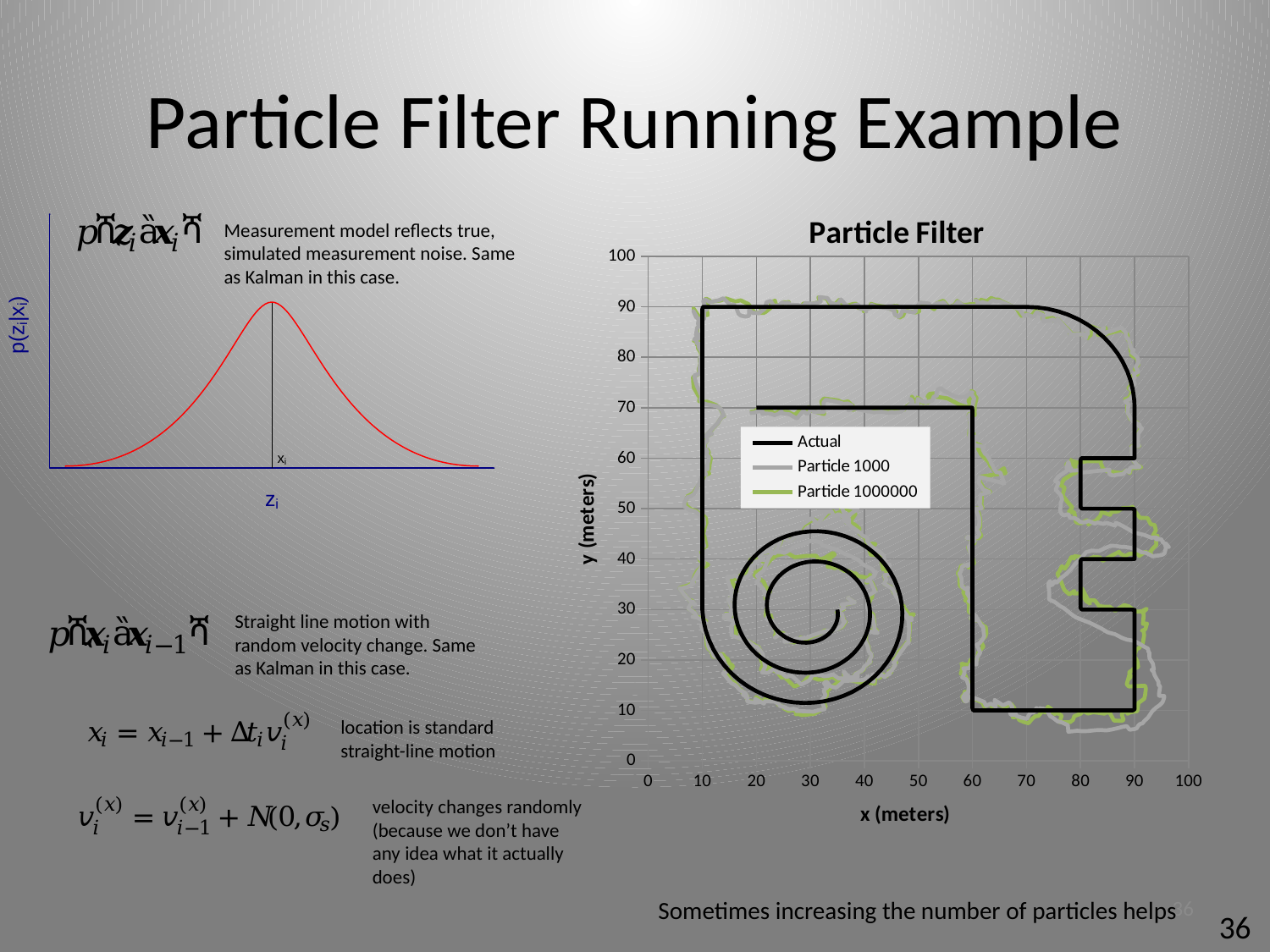
In the Particle Filter chart, is the lowest y value reached by the Actual line greater or less than 5? greater What are the three series named in the legend of the Particle Filter chart? Actual, Particle 1000, Particle 1000000 What kind of chart is the Particle Filter chart? line chart In the Particle Filter chart, is the smallest x value reached by the Actual line greater or less than 5? greater What is the title of the chart on the right side of the slide? Particle Filter How many series does the legend of the Particle Filter chart list? 3 In the Particle Filter chart, is the largest x value reached by the Actual line greater or less than 95? less